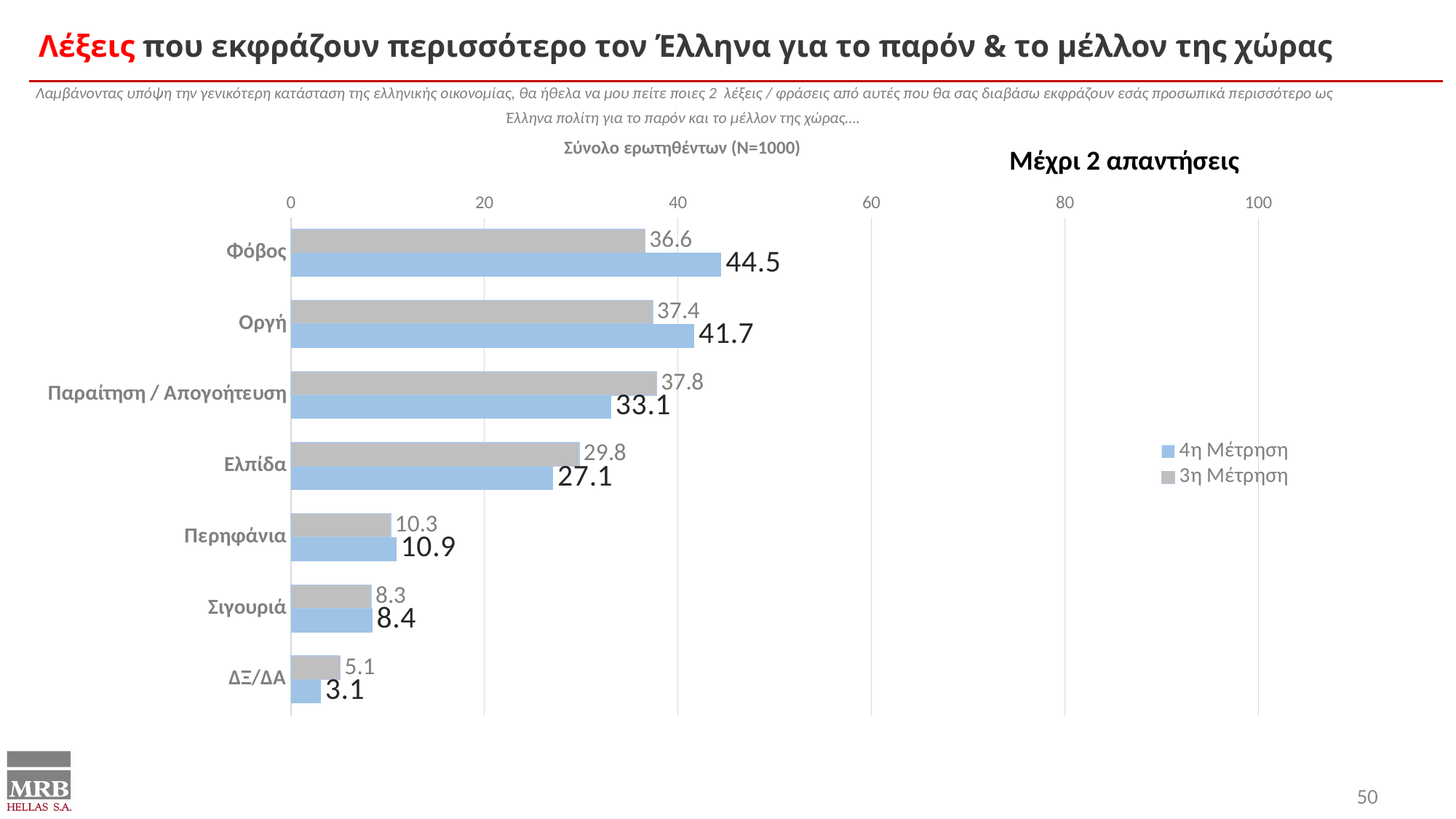
What is the value for Ελπίδα in the 4η Μέτρηση series? 27.1 What is the value for Φόβος in the 4η Μέτρηση series? 44.5 Which category has the lowest value in the 3η Μέτρηση series? ΔΞ/ΔΑ For Οργή, which series has the larger value, 4η Μέτρηση or 3η Μέτρηση? 4η Μέτρηση What is the difference between the 4η Μέτρηση and 3η Μέτρηση values for Φόβος? 7.9 What is the value for Παραίτηση / Απογοήτευση in the 3η Μέτρηση series? 37.8 How many series does the legend list? 2 Is the 4η Μέτρηση value for Ελπίδα greater or less than 40? less What is the difference between the 3η Μέτρηση and 4η Μέτρηση values for Παραίτηση / Απογοήτευση? 4.7 What kind of chart is shown on the slide? bar chart Which category has the highest value in the 4η Μέτρηση series? Φόβος How many categories are shown on the chart? 7